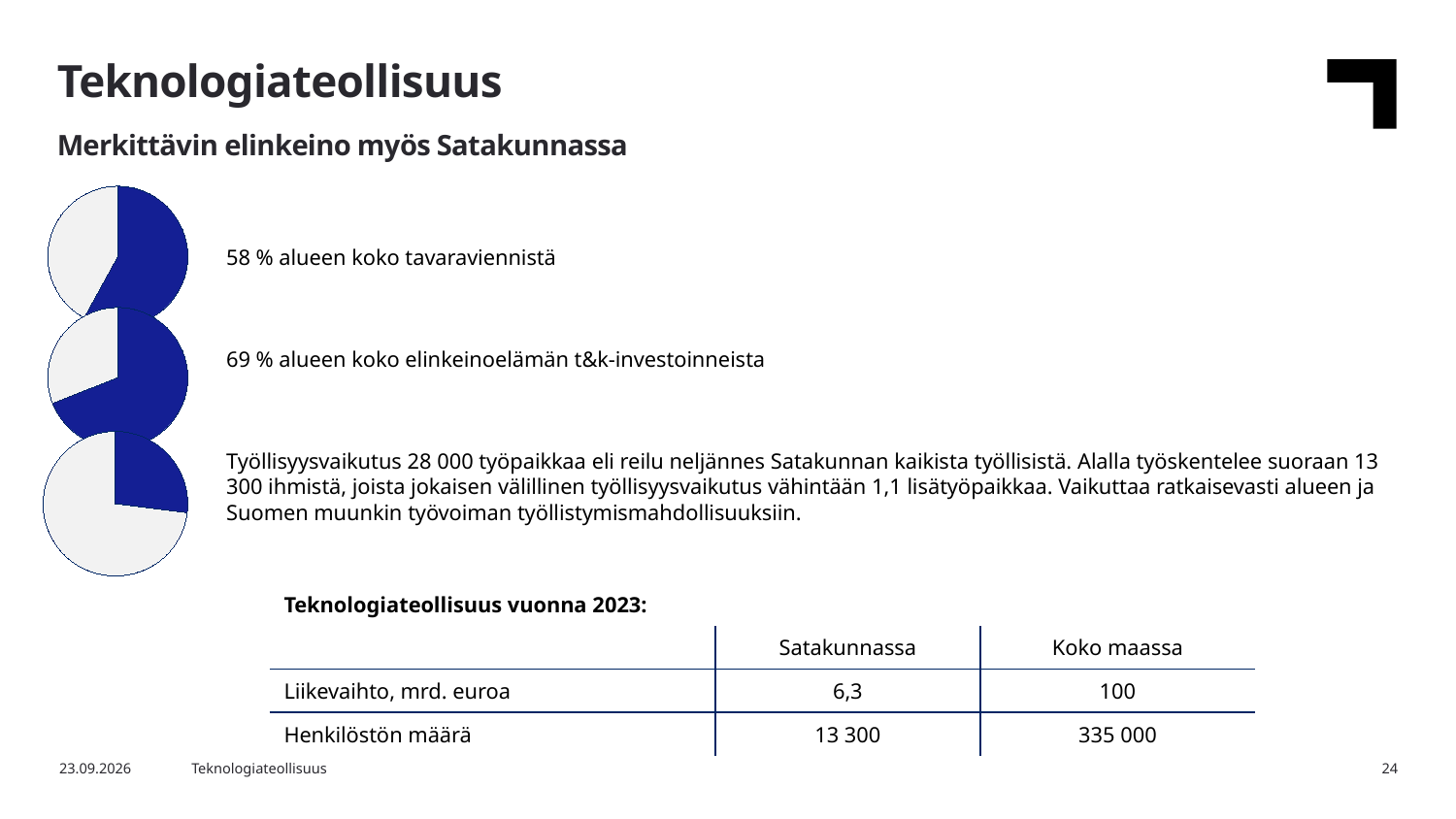
Which of the three pie charts has the largest blue slice? The middle pie chart (69 %) How many slices does each pie chart have? 2 Is the blue slice larger in the top pie chart or in the bottom pie chart? The top pie chart In the top pie chart, what share of the region's total goods exports (tavaravienti) does the blue slice represent? 58 % What is the difference in percentage points between the blue shares of the middle and top pie charts? 11 percentage points Which of the three pie charts has the smallest blue slice? The bottom pie chart Is the blue slice larger in the middle pie chart or in the top pie chart? The middle pie chart What colour is used for the highlighted slice in the pie charts? Blue How many pie charts are on the slide? 3 In the middle pie chart, what share of the region's business R&D investments (t&k-investoinnit) does the blue slice represent? 69 % What does the bottom pie chart illustrate, according to the text next to it? Employment impact: 28 000 jobs, just over a quarter of all employed in Satakunta What kind of charts are shown on the left side of the slide? Pie charts